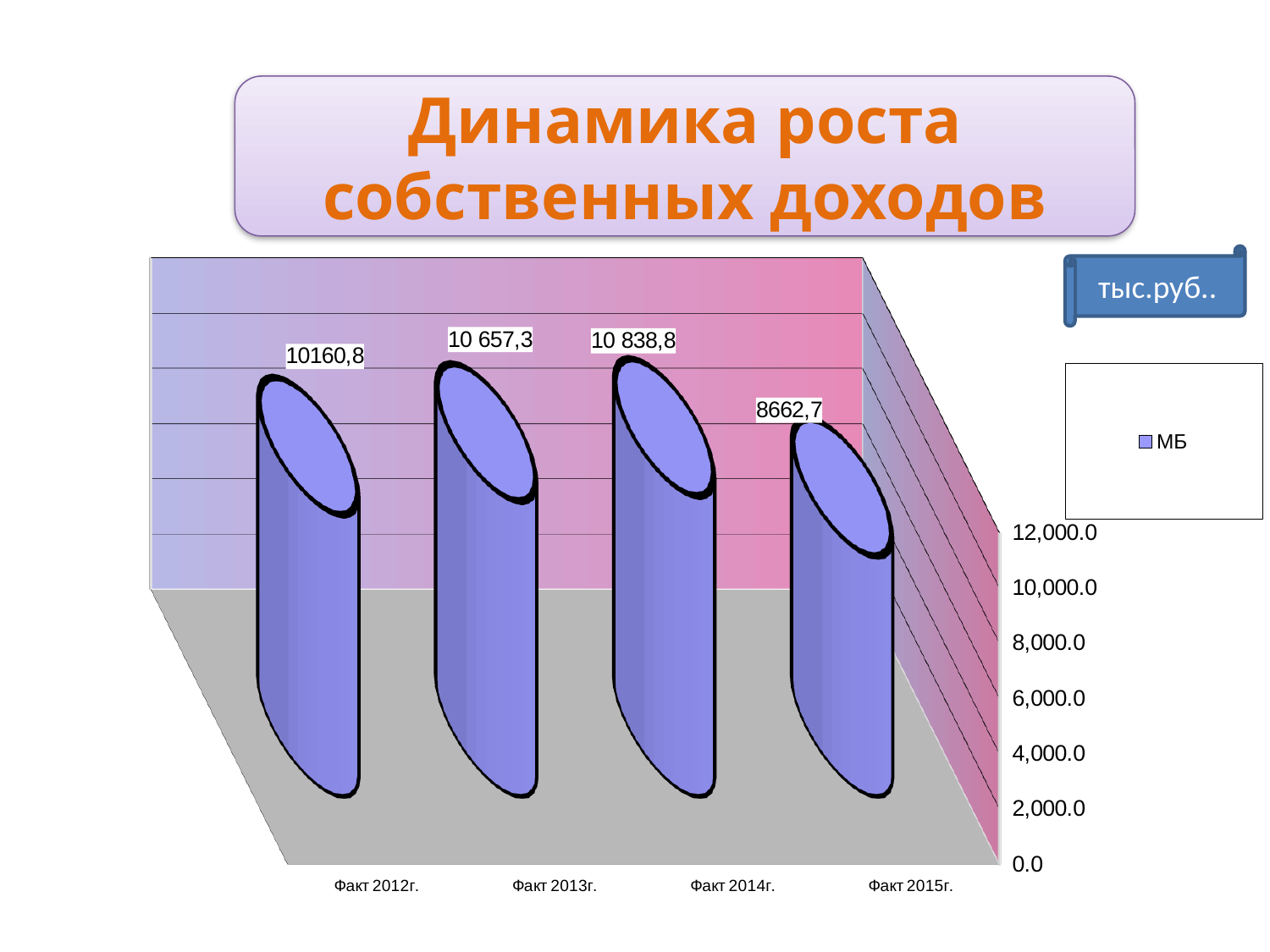
What is the difference between the values for Факт 2012г. and Факт 2015г.? 1498,1 Which category has the highest value? Факт 2014г. What series name does the legend list? МБ What is the value for Факт 2012г.? 10160,8 What is the value for Факт 2014г.? 10 838,8 Which is larger, the value for Факт 2013г. or the value for Факт 2012г.? Факт 2013г. Is the value for Факт 2015г. greater or less than 10,000.0? less Which category has the lowest value? Факт 2015г. How many categories are shown on the x axis? 4 What is the difference between the values for Факт 2014г. and Факт 2013г.? 181,5 What kind of chart is shown on the slide? bar chart What is the value for Факт 2015г.? 8662,7